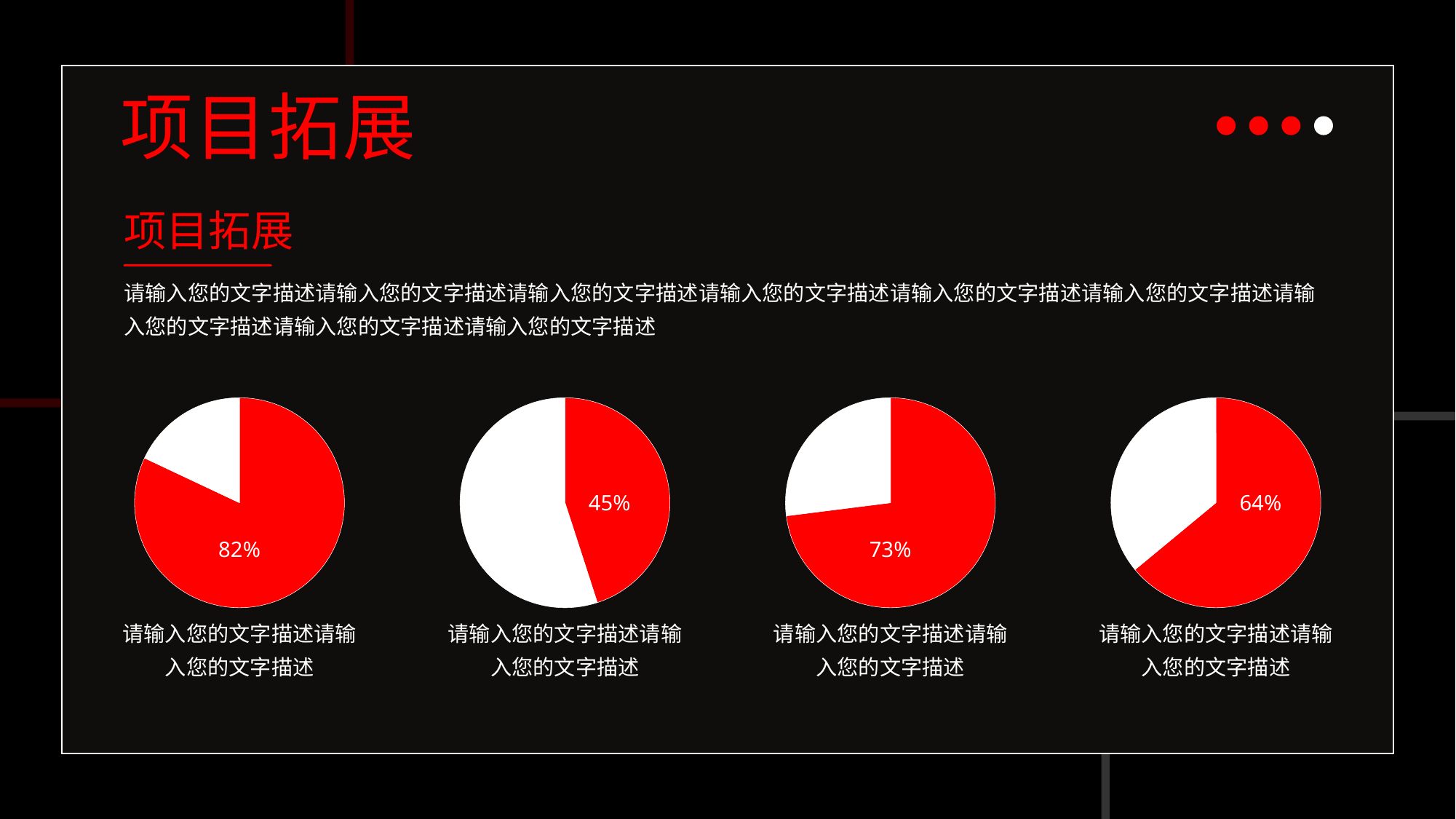
Is the red slice larger in the third pie chart from the left or in the rightmost pie chart? The third pie chart from the left How many slices does each pie chart have? 2 What colour is the slice that carries the percentage label in each pie chart? Red In the second pie chart from the left, what percentage is shown on the red slice? 45% In the leftmost pie chart, what percentage is shown on the red slice? 82% Which pie chart has the smallest labeled red slice? The second pie chart from the left (45%) What is the difference in percentage points between the red slice of the leftmost pie chart and the red slice of the second pie chart from the left? 37 percentage points How many pie charts are on the slide? 4 In the third pie chart from the left, what percentage is shown on the red slice? 73% In the rightmost pie chart, what percentage is shown on the red slice? 64% What kind of charts are shown on the slide? Pie charts Which pie chart has the largest labeled red slice? The leftmost pie chart (82%)